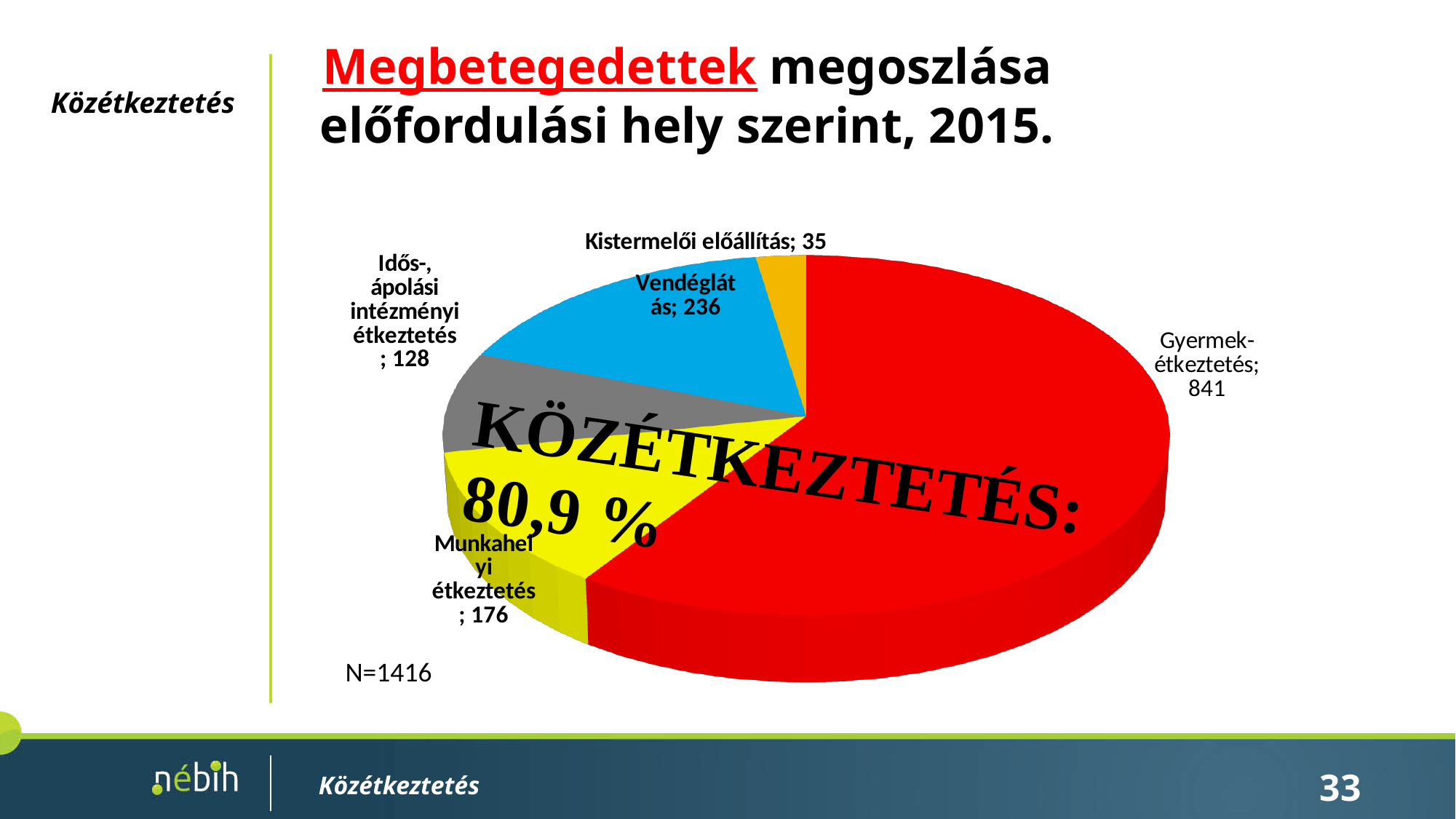
Which is larger, the value for Munkahelyi étkeztetés or the value for Idős-, ápolási intézményi étkeztetés? Munkahelyi étkeztetés What is the value for Munkahelyi étkeztetés? 176 What is the total N shown for the pie chart? N=1416 Which category has the smallest slice of the pie? Kistermelői előállítás What is the value for Kistermelői előállítás? 35 What kind of chart is shown on the slide? Pie chart Which category has the largest slice of the pie? Gyermekétkeztetés What is the difference between the values for Vendéglátás and Idős-, ápolási intézményi étkeztetés? 108 What is the value for Gyermekétkeztetés? 841 How many slices does the pie chart have? 5 What is the value for Vendéglátás? 236 What percentage is printed in the large overlay text on the pie chart for KÖZÉTKEZTETÉS? 80,9 %